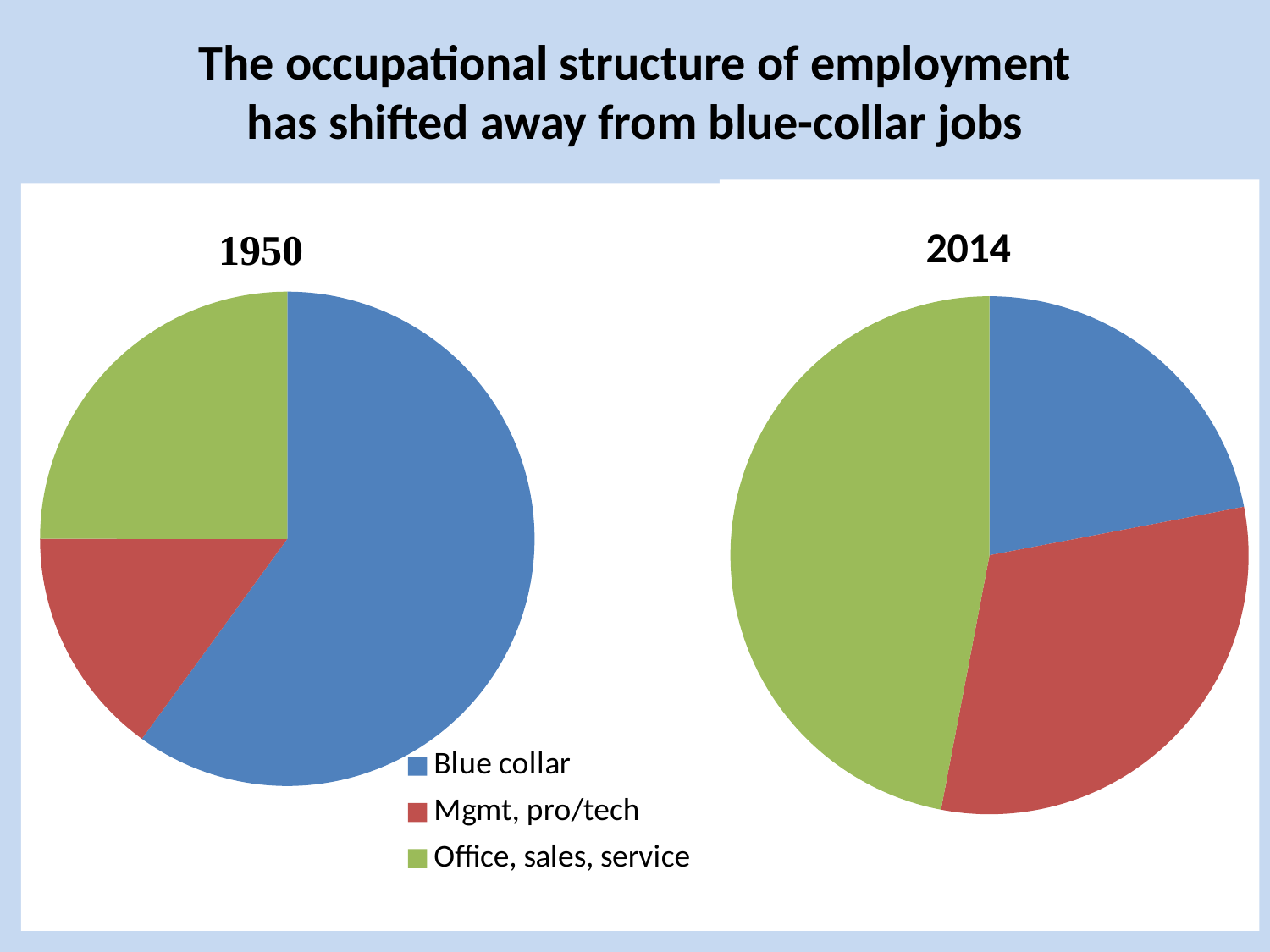
How many slices does the 1950 pie chart have? 3 How many categories does the legend list? 3 In the 1950 pie chart, which category has the largest slice? Blue collar What kind of chart is the 1950 chart? pie chart Which colour represents Mgmt, pro/tech in the pie charts? red In the 1950 pie chart, which slice is larger: Blue collar or Office, sales, service? Blue collar In the 2014 pie chart, which category has the smallest slice? Blue collar What is the title of the slide containing the two pie charts? The occupational structure of employment has shifted away from blue-collar jobs In the 1950 pie chart, which category has the smallest slice? Mgmt, pro/tech In the 2014 pie chart, which category has the largest slice? Office, sales, service What kind of chart is the 2014 chart? pie chart In the 2014 pie chart, which slice is larger: Office, sales, service or Blue collar? Office, sales, service